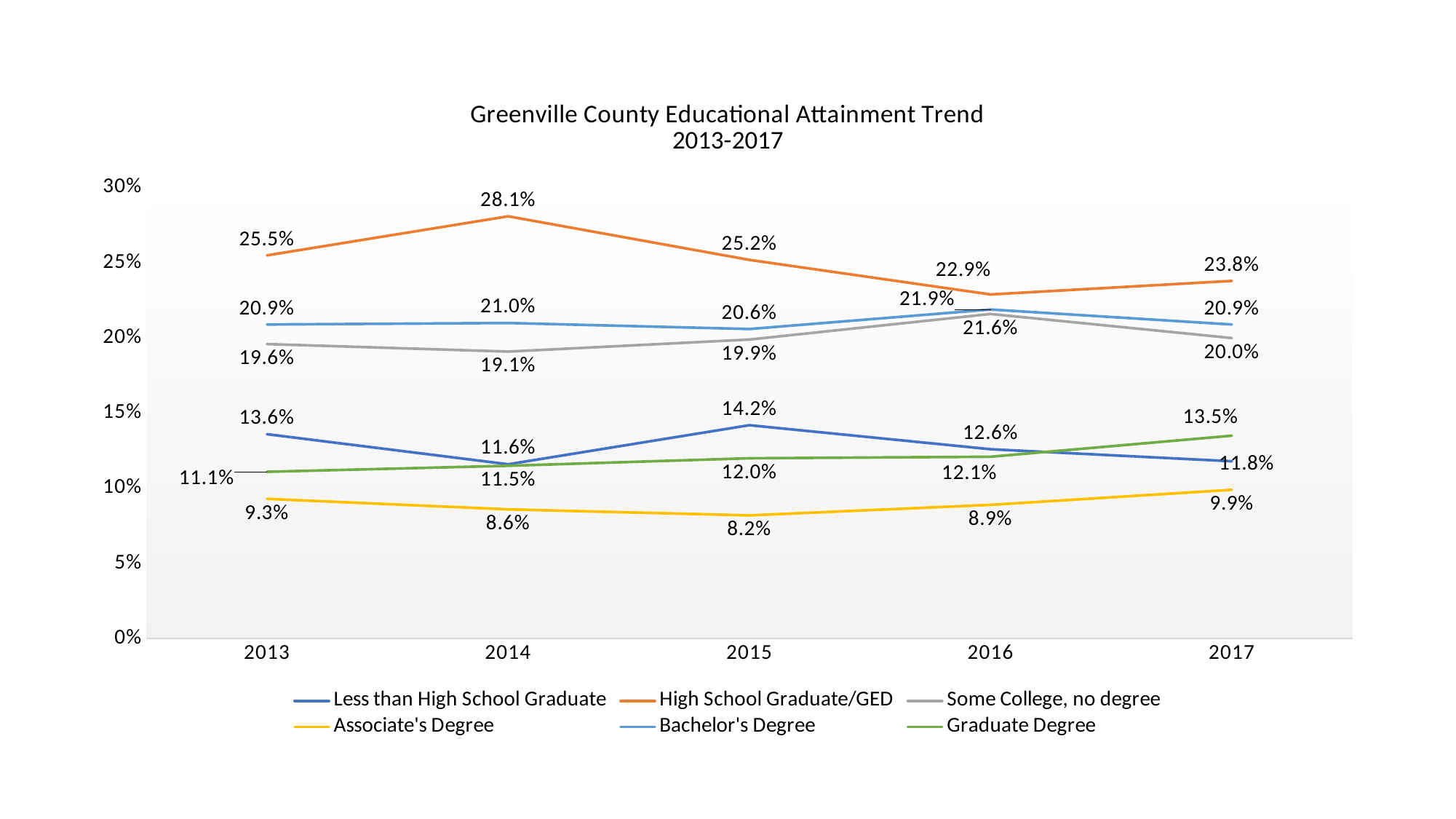
In which year was the High School Graduate/GED value highest? 2014 Which was larger in 2017, Less than High School Graduate or Graduate Degree? Graduate Degree How many years are shown on the x axis? 5 What is the value for Associate's Degree in 2015? 8.2% Did the Graduate Degree value rise or fall from 2013 to 2017? rise What is the value for Graduate Degree in 2017? 13.5% In which year was the Associate's Degree value lowest? 2015 What is the value for High School Graduate/GED in 2014? 28.1% What is the title of the chart? Greenville County Educational Attainment Trend 2013-2017 What type of chart is shown on the slide? line chart What is the difference between the High School Graduate/GED values in 2014 and 2016? 5.2% How many series does the legend list? 6